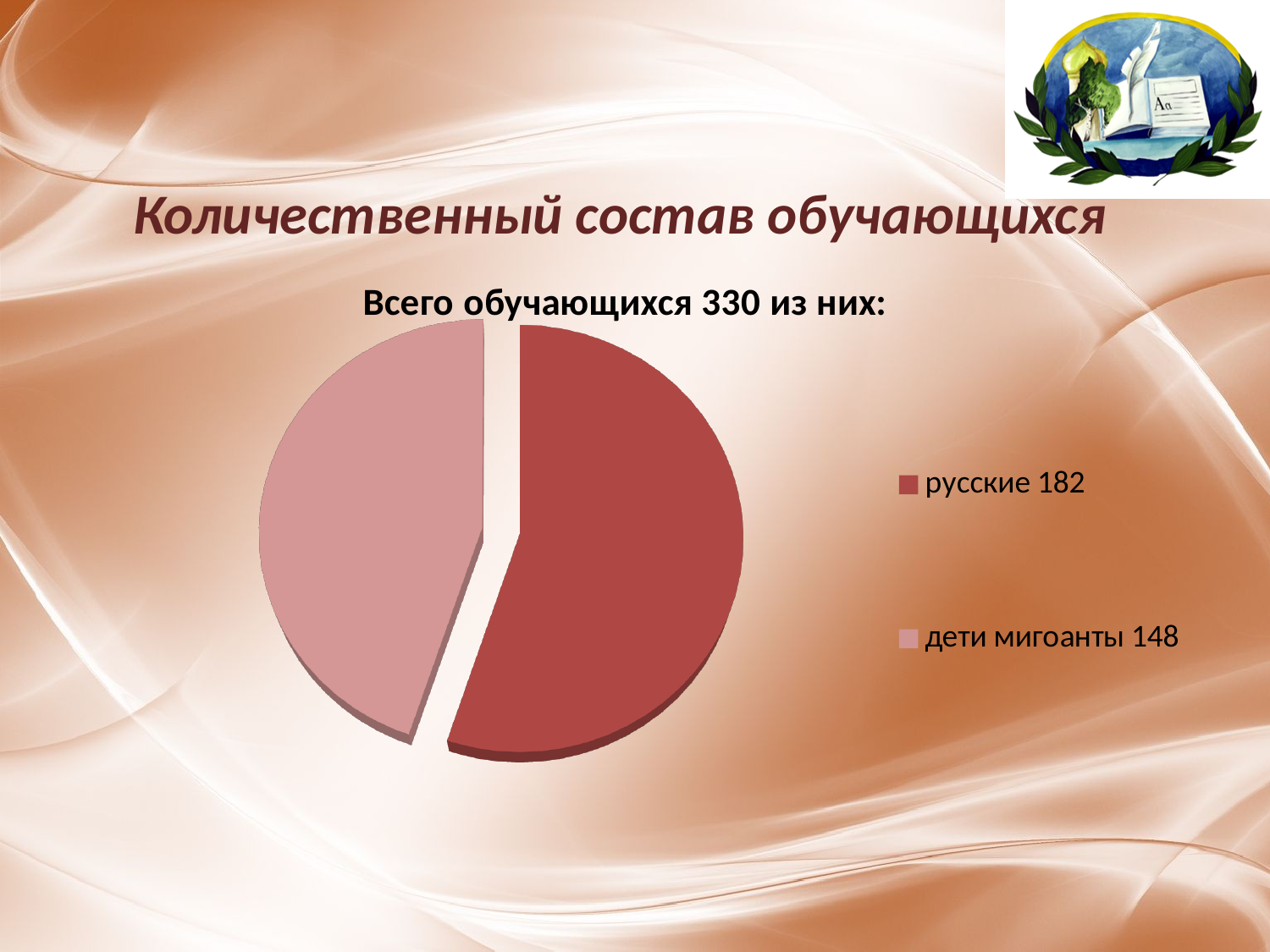
How many entries does the legend of the pie chart list? 2 What kind of chart is shown on the slide? pie chart Which is larger, the value for русские or the value for дети мигоанты? русские Which legend entry is shown in the darker red colour? русские 182 Which category has the smallest slice in the pie chart? дети мигоанты What is the value for дети мигоанты in the pie chart? 148 How many slices does the pie chart have? 2 What is the total number of students shown in the chart title? 330 What is the difference between the values for русские and дети мигоанты? 34 What is the value for русские in the pie chart? 182 Which category has the largest slice in the pie chart? русские What is the title of the pie chart? Всего обучающихся 330 из них: